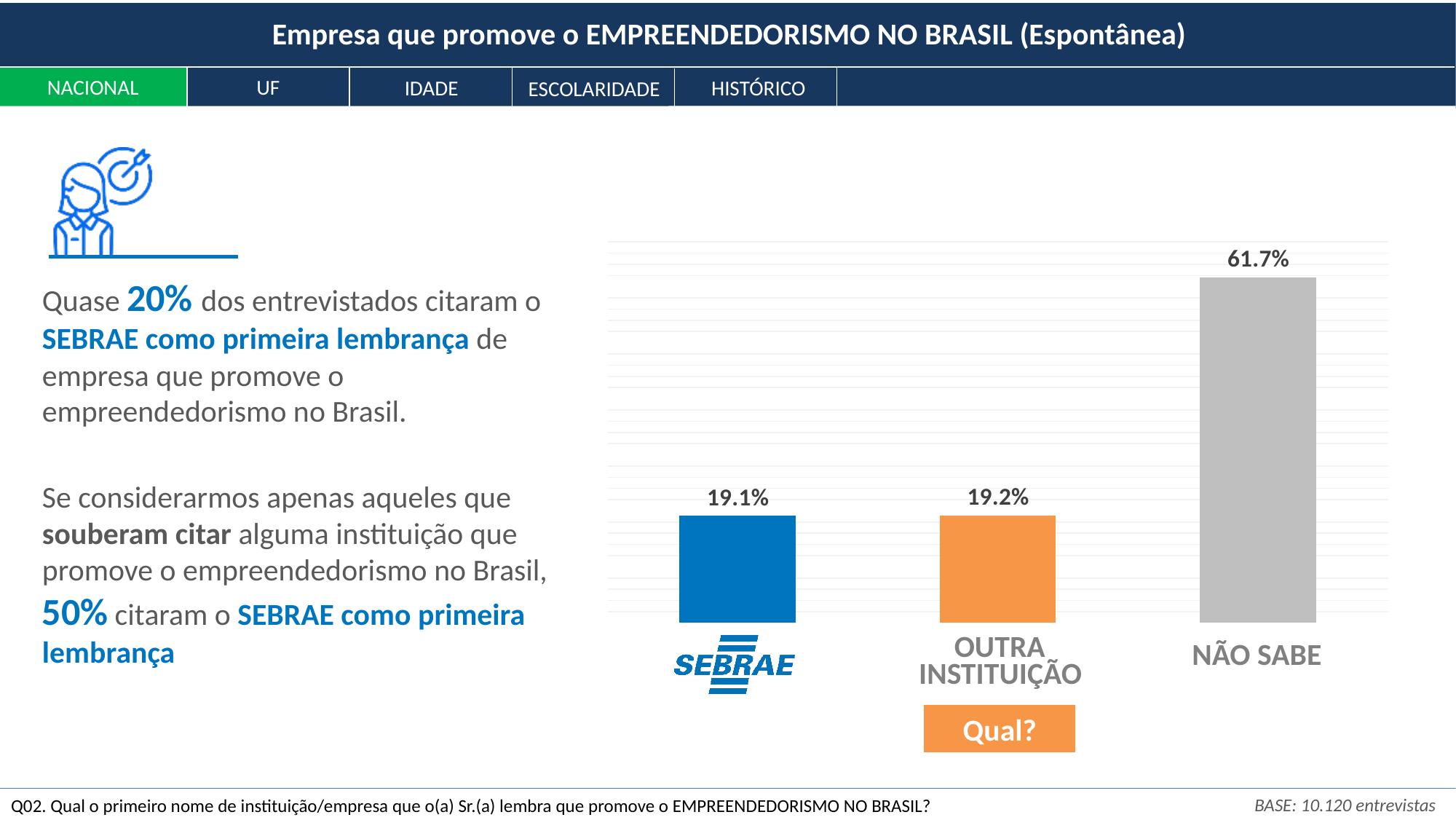
What is the difference between the NÃO SABE value and the SEBRAE value? 42.6% What is the value shown for OUTRA INSTITUIÇÃO? 19.2% What percentage of respondents cited SEBRAE as the company that promotes entrepreneurship in Brazil? 19.1% What kind of chart is shown on the slide? Bar chart What is the difference between the OUTRA INSTITUIÇÃO value and the SEBRAE value? 0.1% What is the value shown for NÃO SABE? 61.7% What is the title of the slide containing the chart? Empresa que promove o EMPREENDEDORISMO NO BRASIL (Espontânea) What colour is the bar for OUTRA INSTITUIÇÃO? Orange How many categories are shown in the chart? 3 Which is larger, the value for NÃO SABE or the value for OUTRA INSTITUIÇÃO? NÃO SABE Which category has the highest value in the chart? NÃO SABE